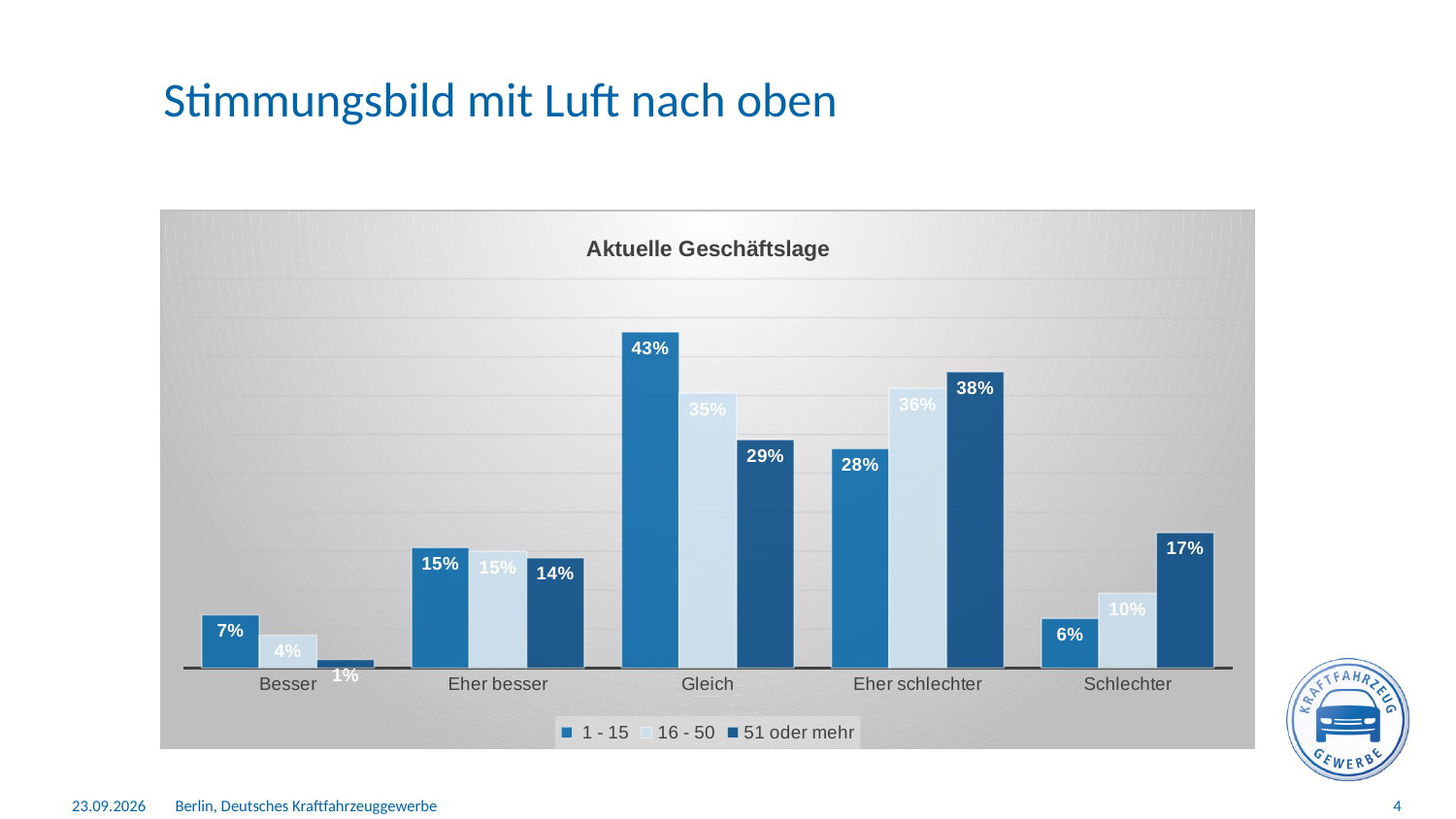
What is the value for "51 oder mehr" in the "Besser" category? 1% How many categories are shown on the x axis? 5 What is the value for "51 oder mehr" in the "Schlechter" category? 17% What is the value for "16 - 50" in the "Eher schlechter" category? 36% How many series does the legend list? 3 What is the title of the chart? Aktuelle Geschäftslage Which category has the lowest value for the "51 oder mehr" series? Besser Which category has the highest value for the "1 - 15" series? Gleich What is the difference between the "1 - 15" and "51 oder mehr" values in the "Gleich" category? 14% What kind of chart is shown on the slide? Bar chart What is the value for "1 - 15" in the "Gleich" category? 43% In the "Eher schlechter" category, which is larger: the value for "1 - 15" or for "51 oder mehr"? 51 oder mehr